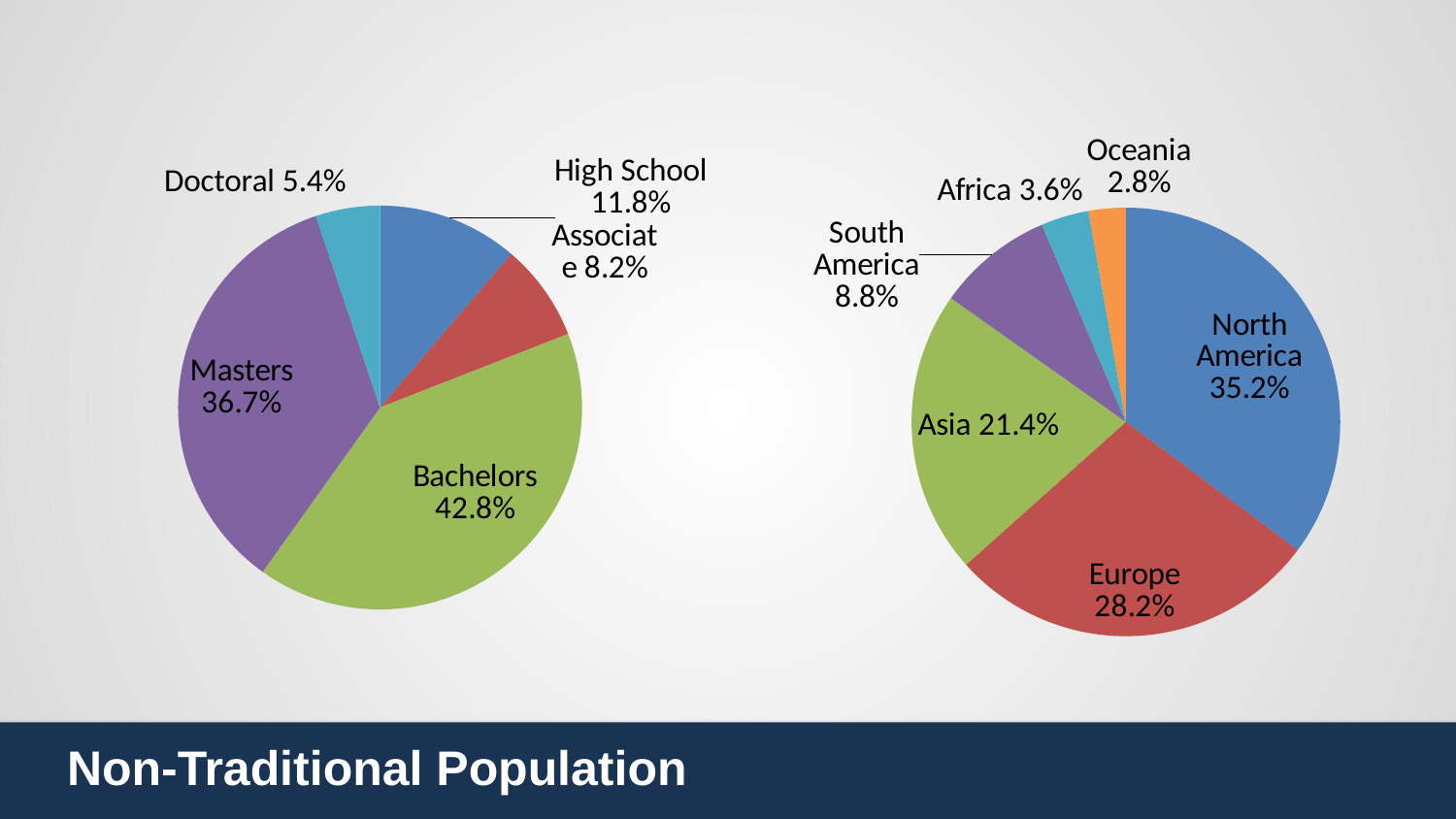
On the right pie chart, which region has the largest share? North America On the left pie chart, which category has the largest share? Bachelors On the right pie chart, which region has the smallest share? Oceania On the left pie chart, which category has the smallest share? Doctoral On the right pie chart, which is larger, Asia or Europe? Europe On the left pie chart, what is the difference between the Bachelors and Masters shares? 6.1% On the left pie chart, what share does Bachelors have? 42.8% What type of chart is shown on the right side of the slide? Pie chart On the right pie chart, what share does Europe have? 28.2% On the left pie chart, what share does Doctoral have? 5.4% On the left pie chart, how many slices are there? 5 On the right pie chart, what share does South America have? 8.8%